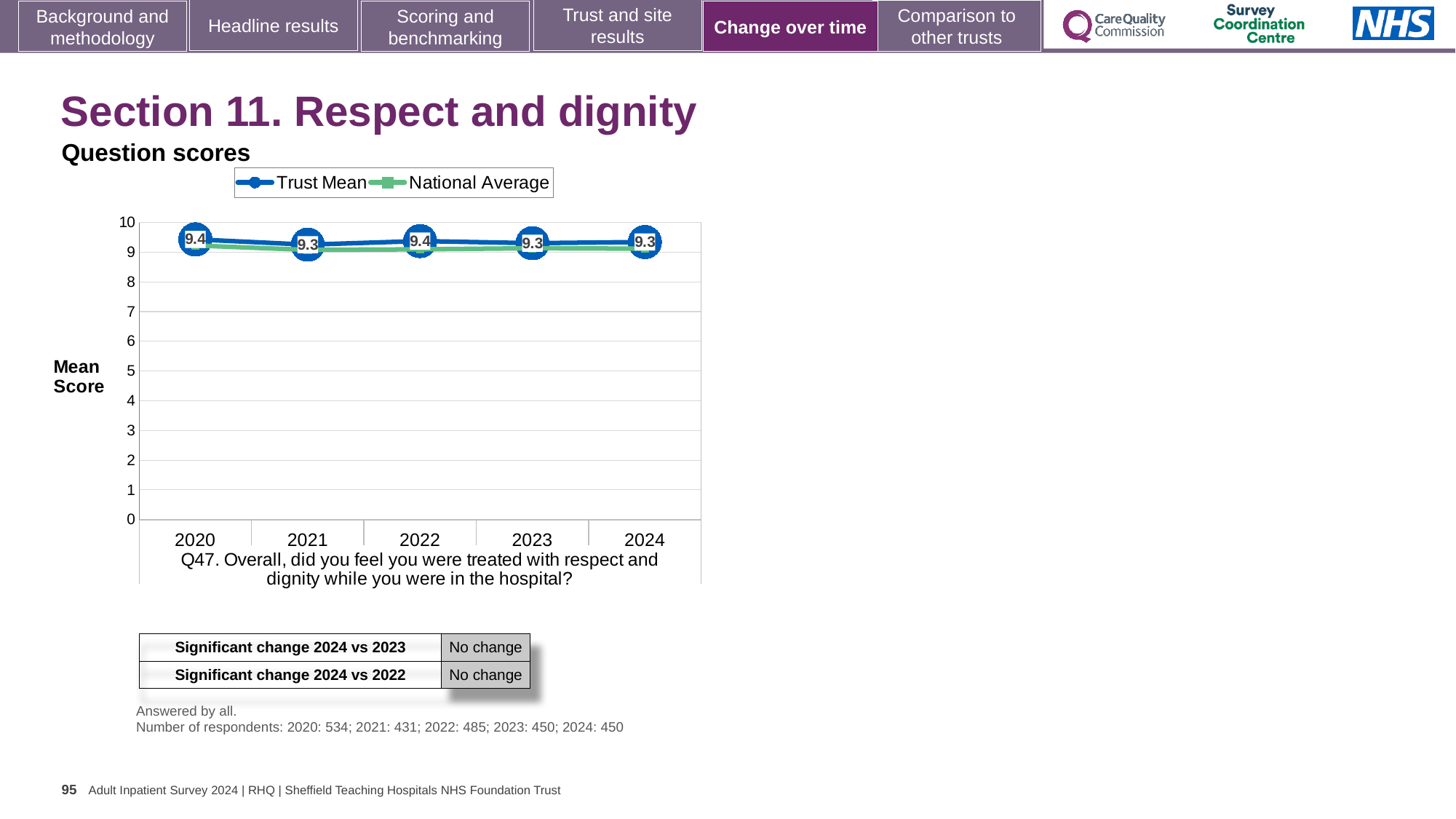
What is the label on the y axis? Mean Score Is the National Average value for 2024 greater or less than 8? greater Which is larger, the Trust Mean score for 2022 or for 2023? 2022 What is the Trust Mean score for 2020? 9.4 What is the Trust Mean score for 2022? 9.4 What is the Trust Mean score for 2021? 9.3 Which two series are listed in the legend? Trust Mean and National Average How many series does the legend list? 2 What kind of chart is shown? line chart What is the difference between the Trust Mean scores for 2020 and 2021? 0.1 What is the Trust Mean score for 2024? 9.3 How many years are plotted on the x axis? 5